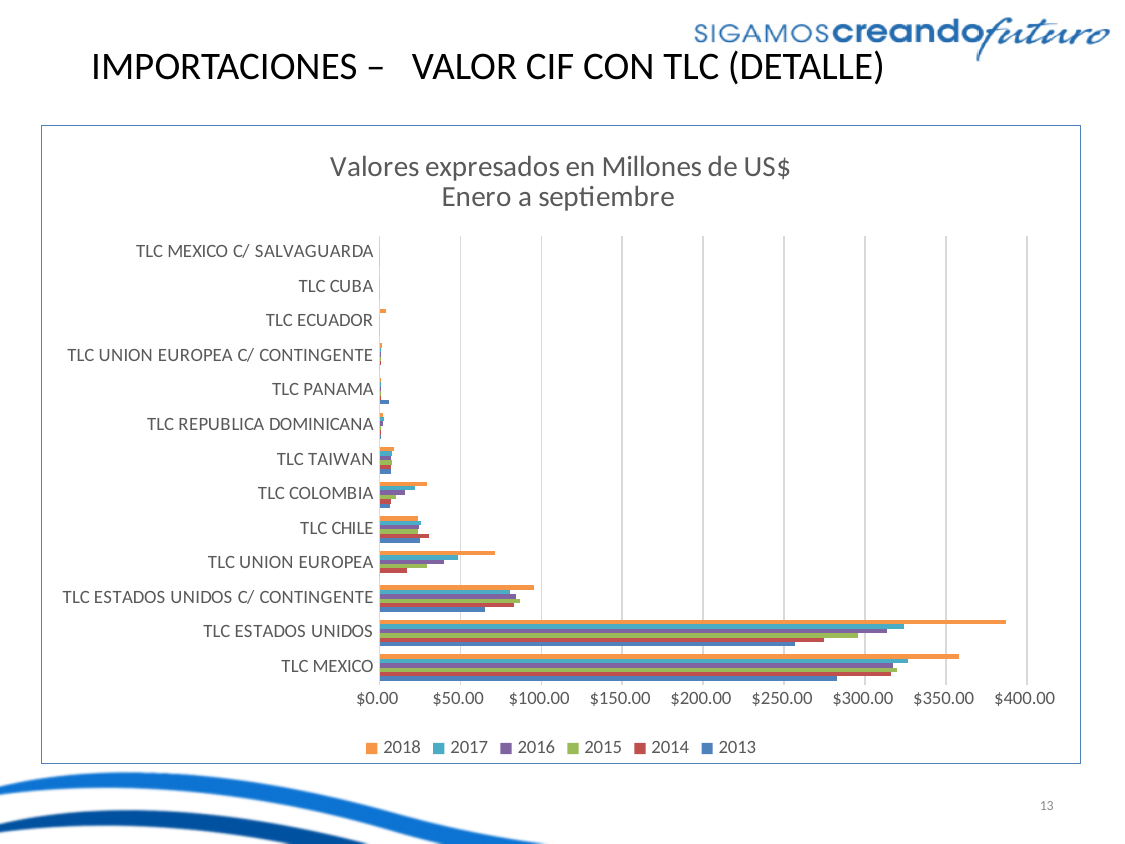
Which category has the highest value for the 2013 series? TLC MEXICO How many series does the chart legend list? 6 What is the first line of the chart title? Valores expresados en Millones de US$ For TLC ESTADOS UNIDOS, do the values rise or fall from 2013 to 2018? rise Is the 2018 value for TLC COLOMBIA greater or less than $50.00? less Is the 2018 value for TLC UNION EUROPEA greater or less than $50.00? greater How many TLC categories are listed on the vertical axis of the chart? 13 Is the 2013 value for TLC MEXICO greater or less than $300.00? less For the 2018 series, which is larger: TLC ESTADOS UNIDOS or TLC MEXICO? TLC ESTADOS UNIDOS Which category has the highest value for the 2018 series? TLC ESTADOS UNIDOS What kind of chart is shown on the slide? Bar chart